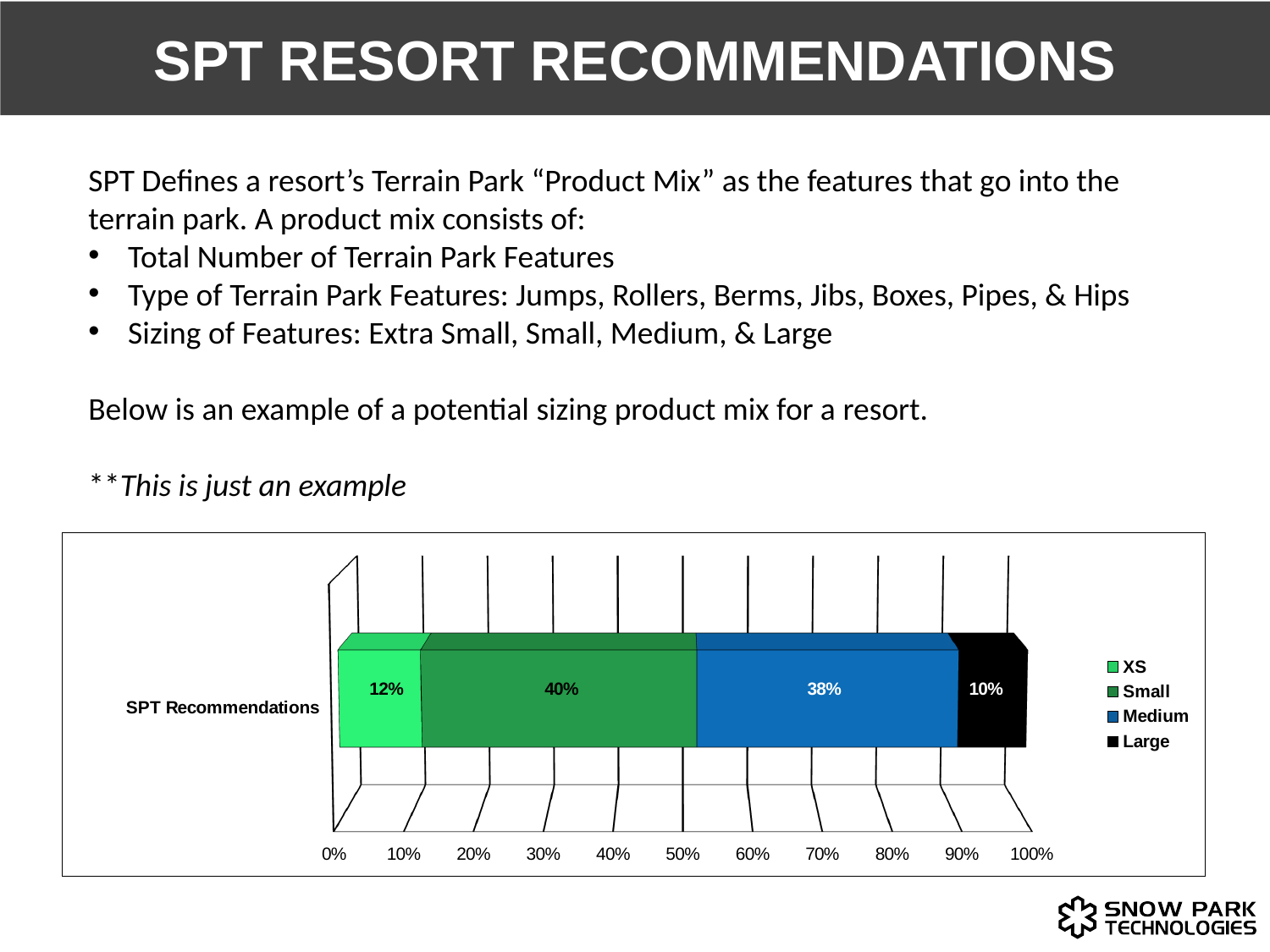
What percentage does the XS segment represent in the SPT Recommendations bar? 12% What percentage does the Large segment represent in the SPT Recommendations bar? 10% How many series does the legend list? 4 What is the total of the stacked SPT Recommendations bar? 100% What percentage does the Medium segment represent in the SPT Recommendations bar? 38% What kind of chart is shown on the slide? Stacked bar chart What percentage does the Small segment represent in the SPT Recommendations bar? 40% Which size category has the largest share in the SPT Recommendations bar? Small What is the difference between the XS and Large percentages? 2% What is the difference between the Small and Medium percentages? 2% Which is larger, the XS share or the Large share? XS Which size category has the smallest share in the SPT Recommendations bar? Large